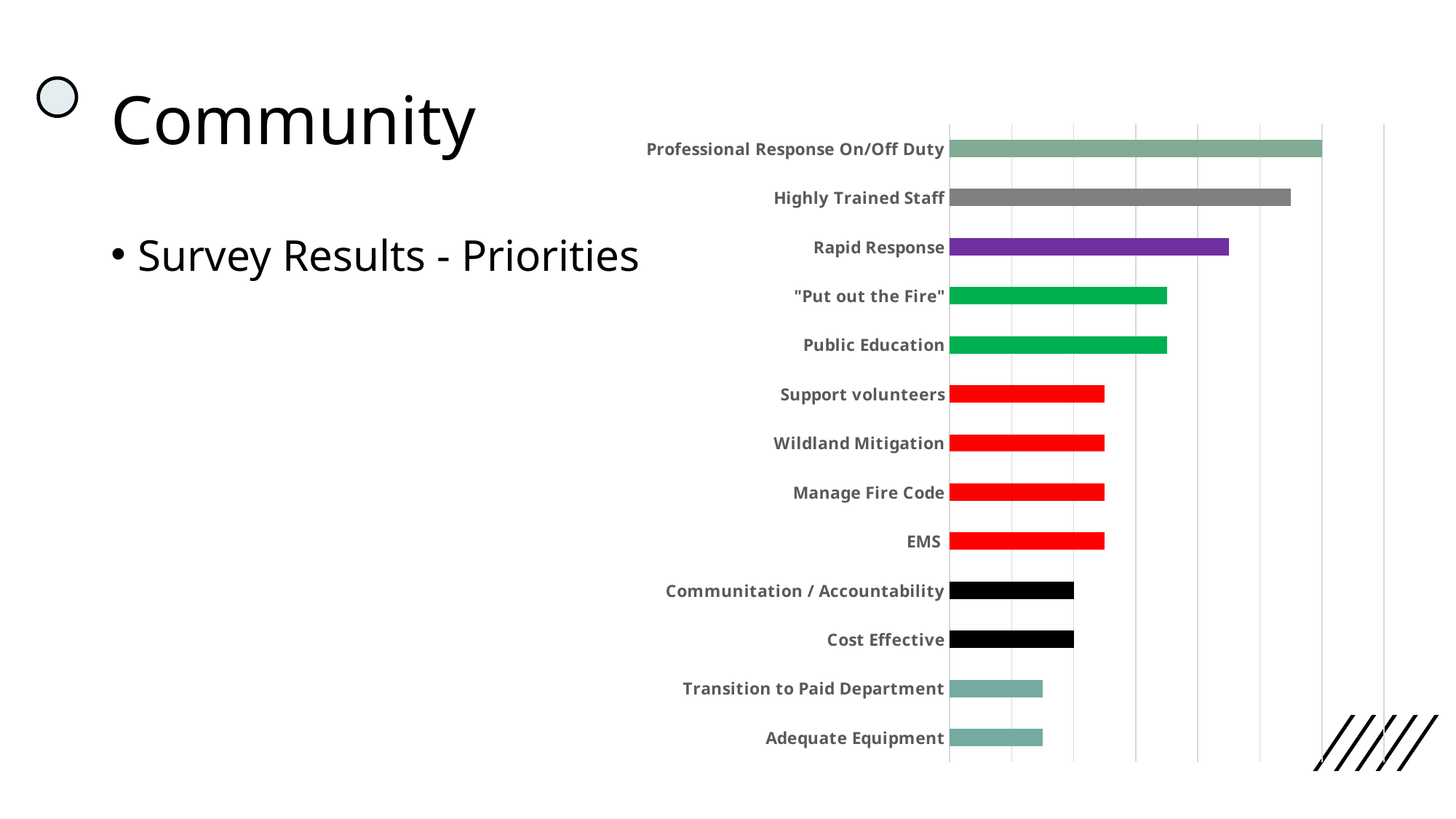
How many categories are plotted in the bar chart? 13 Which is larger, the value for Rapid Response or the value for Public Education? Rapid Response Which is larger, the value for EMS or the value for Transition to Paid Department? EMS What colour is the bar for Rapid Response? purple Do the bar lengths increase or decrease going from the top category to the bottom category? decrease Which is larger, the value for Support volunteers or the value for Cost Effective? Support volunteers Which category has the longest bar in the chart? Professional Response On/Off Duty What kind of chart is shown on the slide? bar chart How many bars in the chart are coloured red? 4